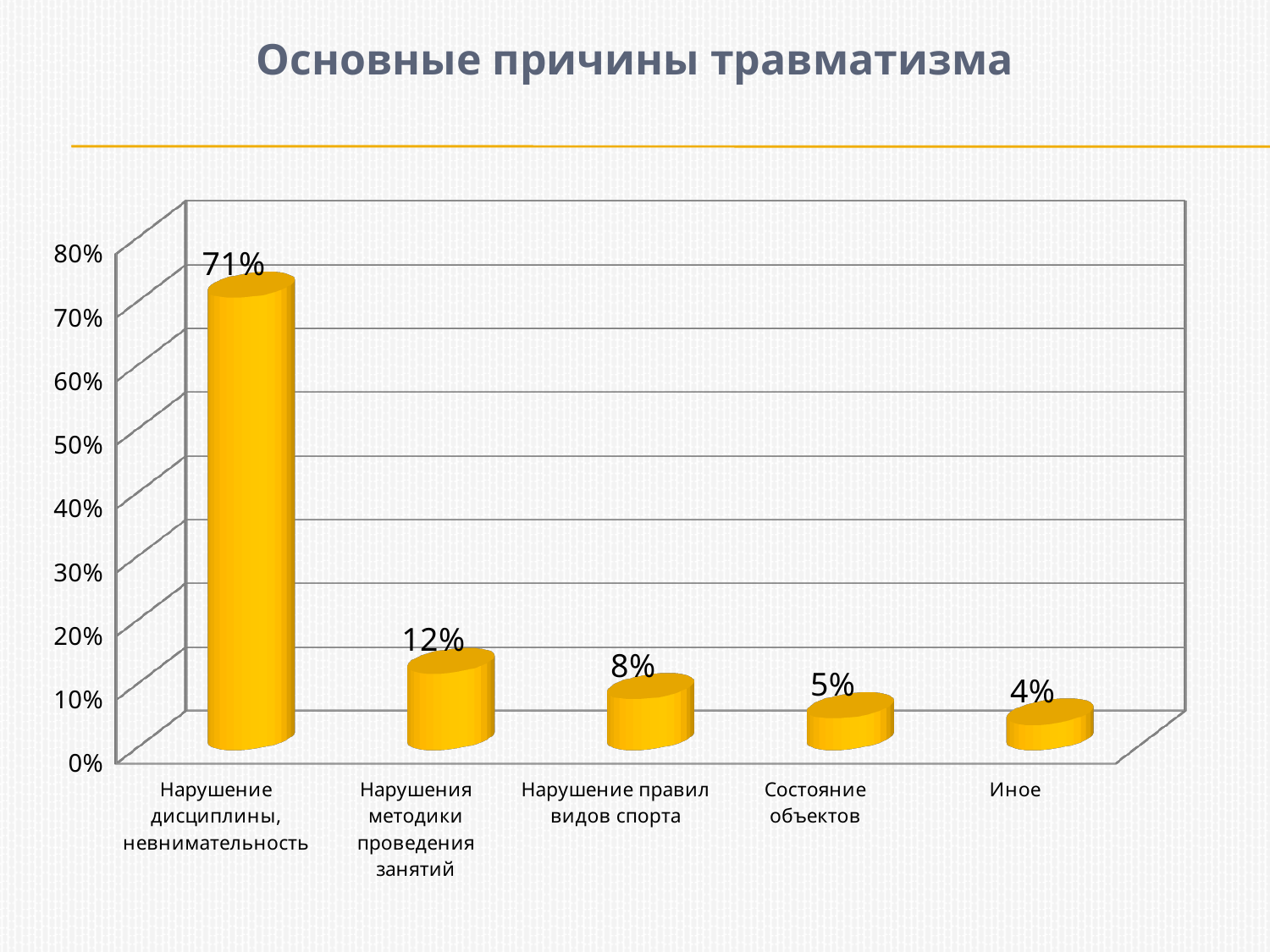
What is the difference between «Нарушение дисциплины, невнимательность» and «Нарушения методики проведения занятий»? 59% Which is larger: «Нарушение правил видов спорта» or «Состояние объектов»? Нарушение правил видов спорта Which category has the highest value? Нарушение дисциплины, невнимательность How many categories are shown on the chart? 5 What is the value for «Нарушение дисциплины, невнимательность»? 71% What is the value for «Состояние объектов»? 5% What kind of chart is shown on the slide? Bar chart What is the title of the slide? Основные причины травматизма What is the value for «Иное»? 4% Which category has the lowest value? Иное What is the value for «Нарушения методики проведения занятий»? 12% What is the value for «Нарушение правил видов спорта»? 8%